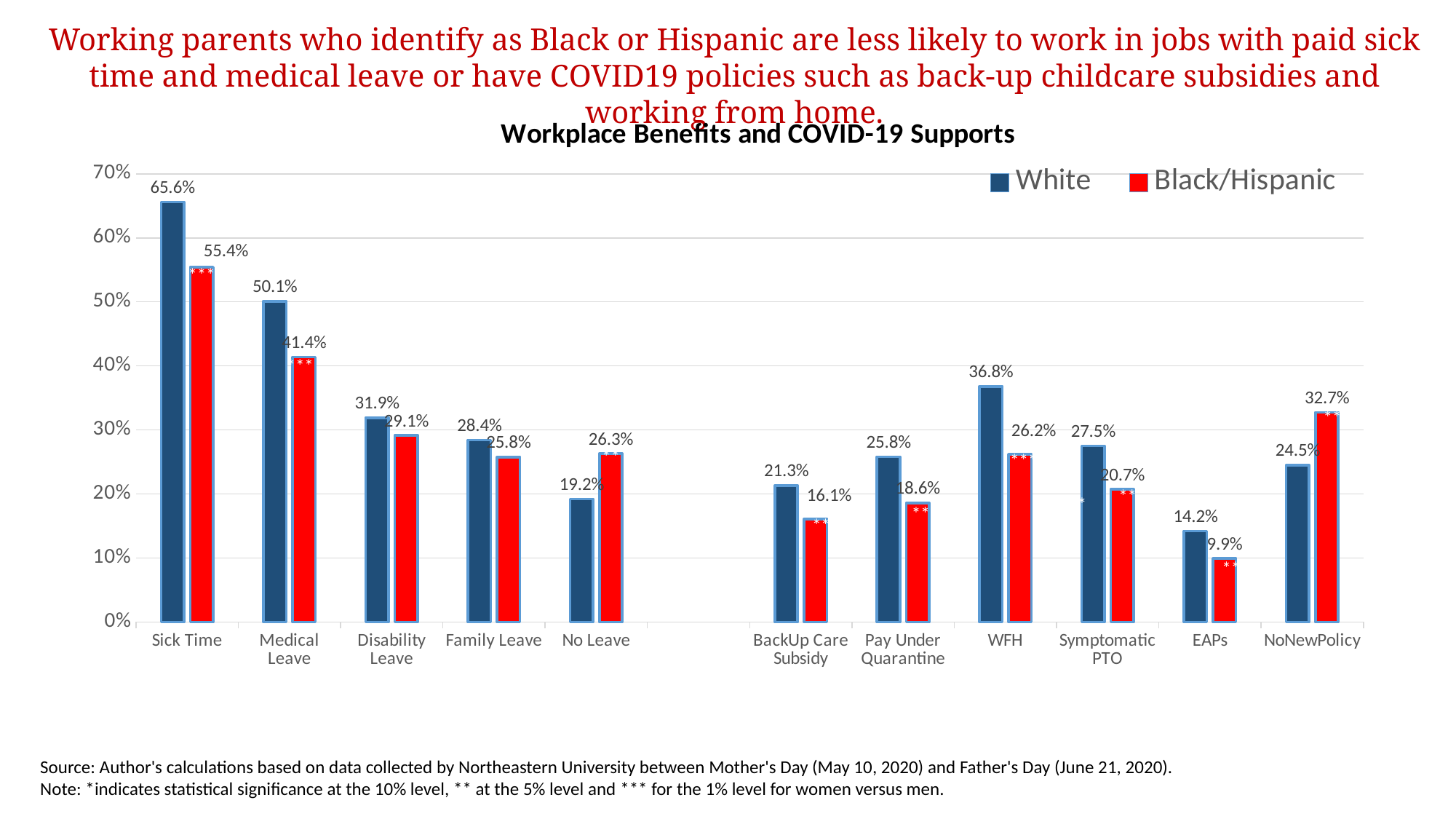
What is the value for White for Sick Time? 65.6% How many series does the legend list? 2 Which category has the lowest value for the Black/Hispanic series? EAPs What is the value for Black/Hispanic for NoNewPolicy? 32.7% What kind of chart is shown on the slide? Bar chart For No Leave, which series has the larger value, White or Black/Hispanic? Black/Hispanic Which category has the highest value for the White series? Sick Time What is the value for Black/Hispanic for WFH? 26.2% What is the difference between the White and Black/Hispanic values for Sick Time? 10.2 percentage points What is the title of the chart? Workplace Benefits and COVID-19 Supports What is the difference between the White and Black/Hispanic values for Medical Leave? 8.7 percentage points How many categories are shown on the x axis? 11